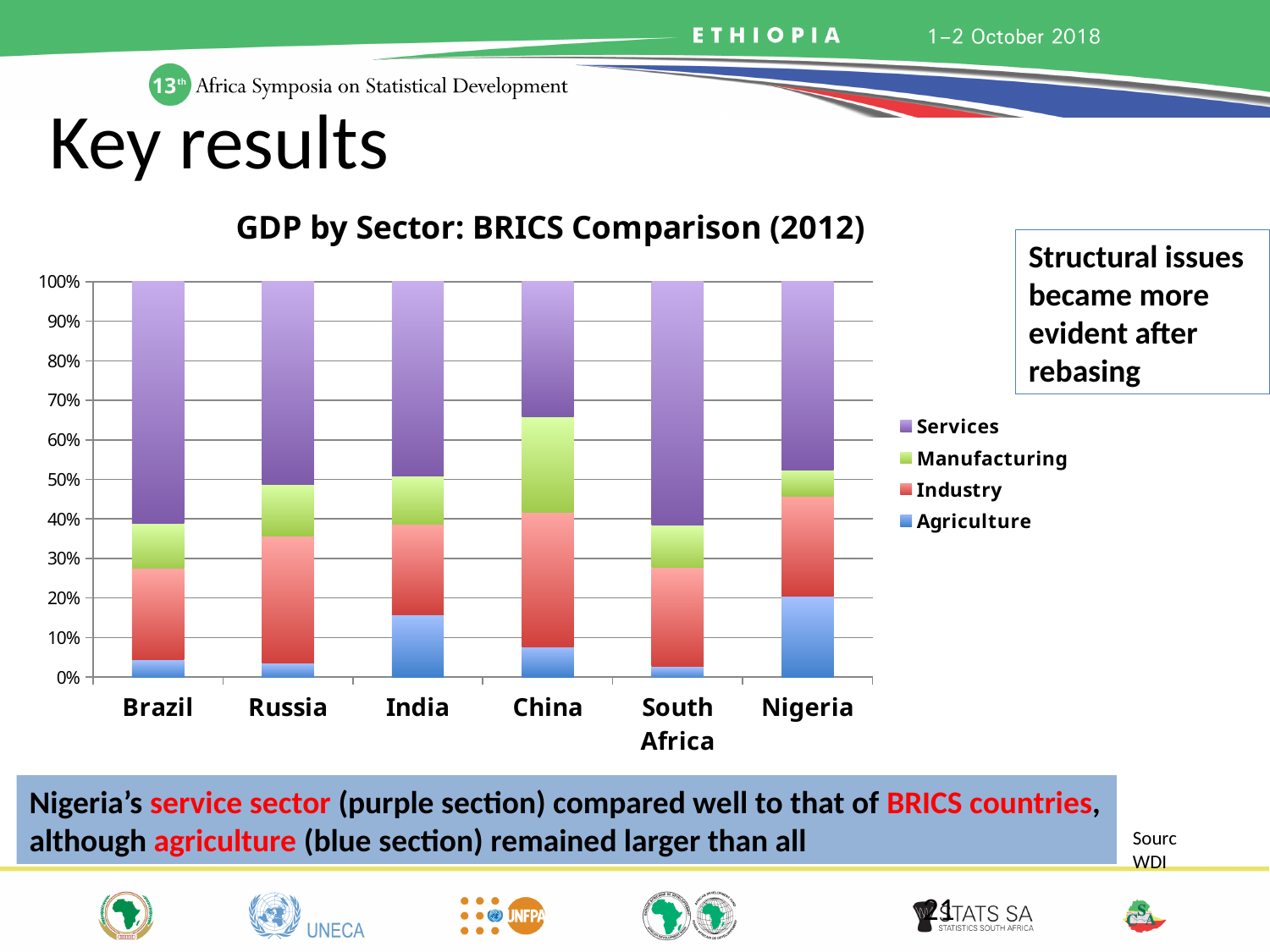
What does each stacked bar in the chart total? 100% Which country has the smallest Services share in the chart? China Which country has the largest Agriculture share in the chart? Nigeria Is the Agriculture share for Brazil greater or less than 10%? less What is the title of the chart? GDP by Sector: BRICS Comparison (2012) Which country has the largest Manufacturing segment in the chart? China What type of chart is shown on the slide? Stacked bar chart Which country has a larger Agriculture share, Nigeria or India? Nigeria Which series is shown in purple in the chart? Services Is the Agriculture share for Nigeria greater or less than 10%? greater How many series does the chart legend list? 4 How many countries are shown on the x axis of the chart? 6